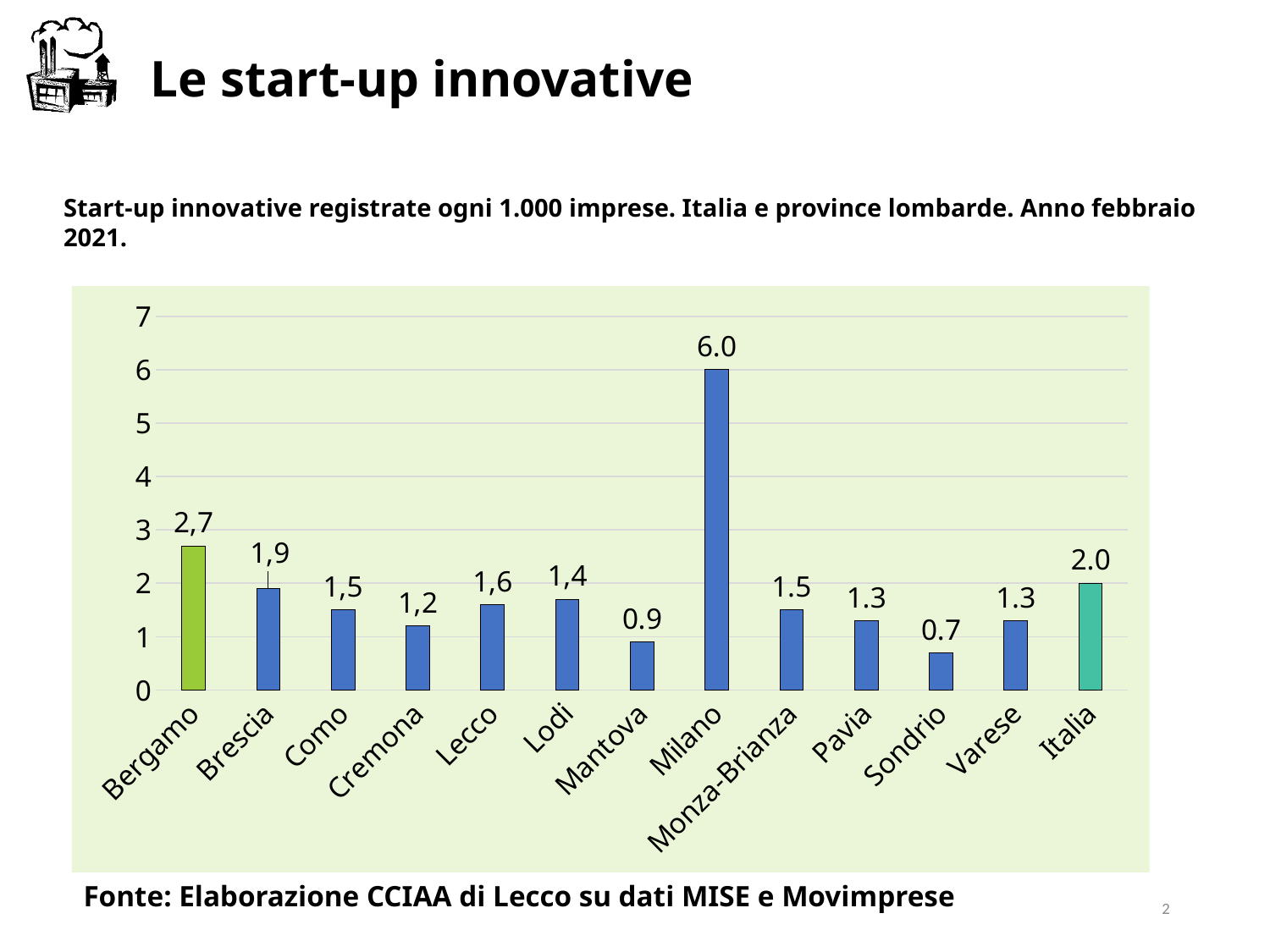
How many categories are shown on the x axis? 13 What is the difference between the values for Milano and Italia? 4.0 Is the value for Milano greater or less than 5? greater What is the value for Bergamo? 2,7 What is the value for Italia? 2.0 What kind of chart is shown on the slide? Bar chart What is the value for Sondrio? 0.7 Which category has the lowest value? Sondrio What is the value for Milano? 6.0 What is the difference between the values for Bergamo and Brescia? 0,8 Which category has the highest value? Milano